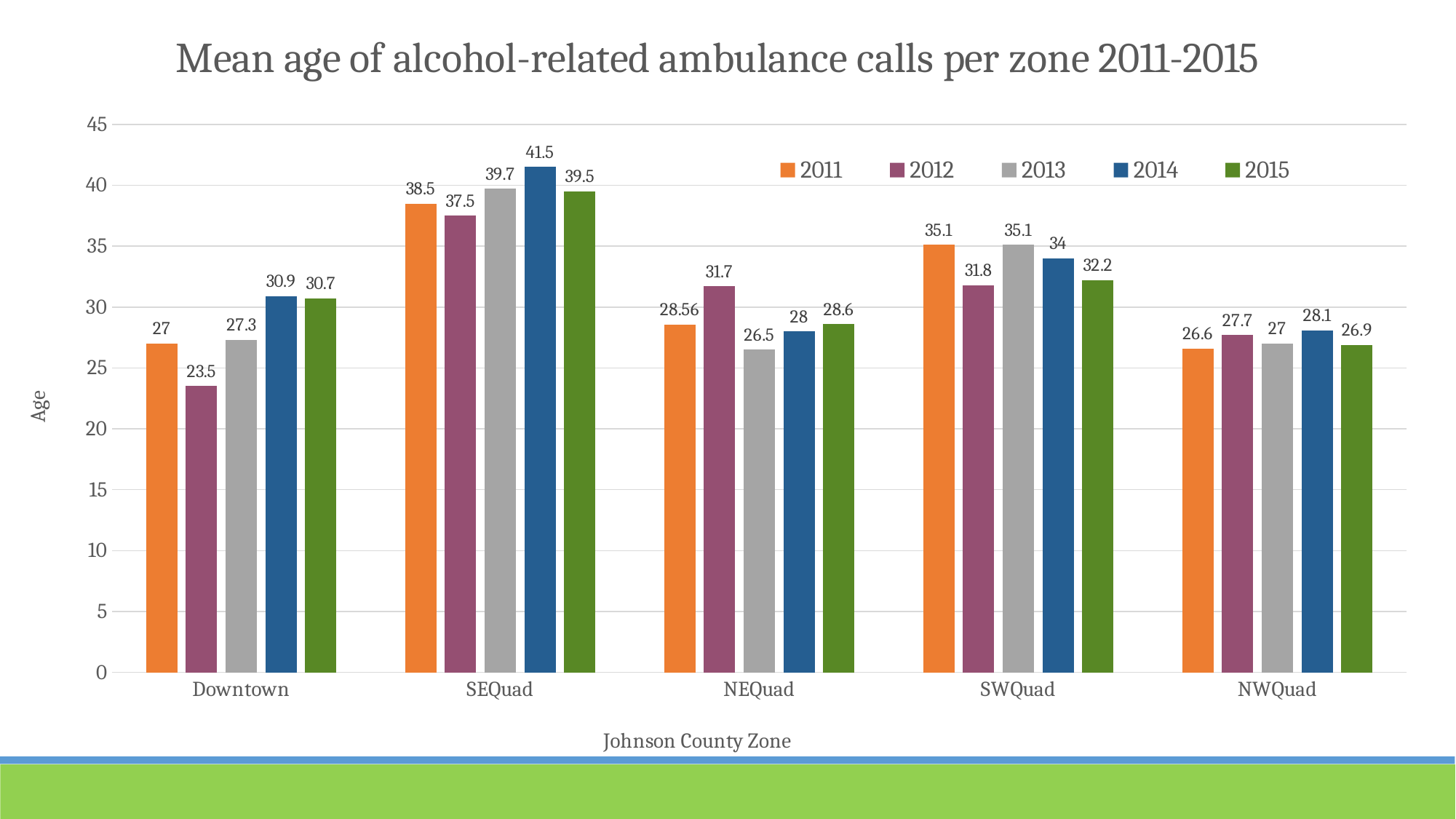
What is the mean age for NEQuad in 2011? 28.56 Which is larger, the 2012 mean age for NEQuad or the 2012 mean age for SWQuad? SWQuad Which zone has the lowest mean age in 2012? Downtown What is the mean age for Downtown in 2012? 23.5 How many zones are shown on the x axis? 5 What is the mean age for NWQuad in 2013? 27 How many series does the legend list? 5 What is the difference between the 2014 and 2012 mean ages for Downtown? 7.4 Which zone has the highest mean age in 2015? SEQuad Is the 2013 mean age for SEQuad greater or less than 35? greater What kind of chart is shown on the slide? Bar chart What is the mean age for SEQuad in 2014? 41.5